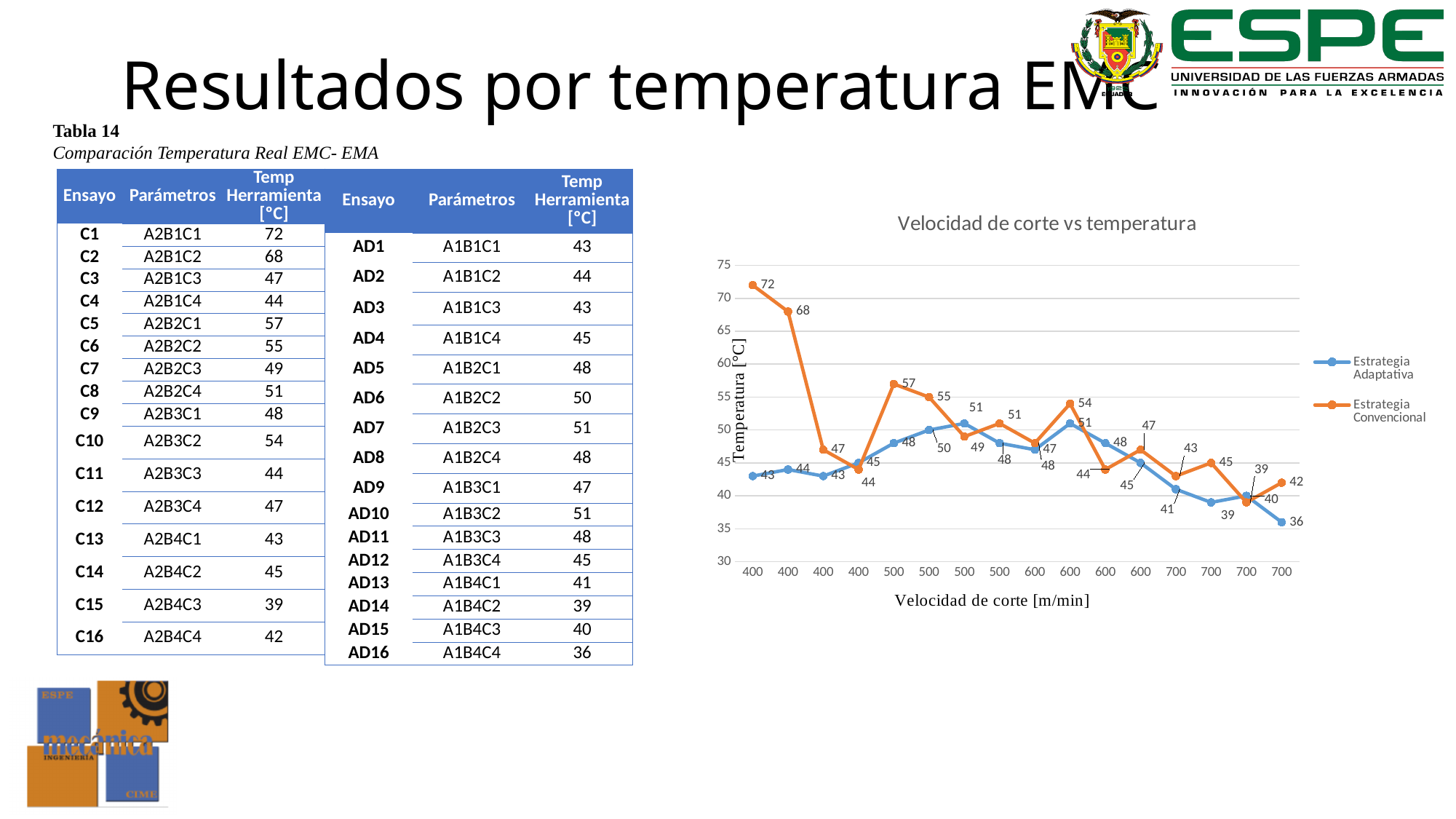
What type of chart is shown on the slide? line chart What is the label of the y axis of the chart? Temperatura [°C] What is the difference between the first point of Estrategia Convencional (72) and the first point of Estrategia Adaptativa (43)? 29 What is the highest value plotted for the Estrategia Convencional series? 72 Overall, do the values of the Estrategia Adaptativa series rise or fall from the first point to the last point? fall How many data points does each series in the chart have? 16 What is the title of the chart on the slide? Velocidad de corte vs temperatura What is the lowest value plotted for the Estrategia Adaptativa series? 36 What is the value of the last point of the Estrategia Adaptativa series? 36 At the first data point, which series has the larger value, Estrategia Adaptativa or Estrategia Convencional? Estrategia Convencional What is the value of the first point of the Estrategia Convencional series? 72 How many series does the chart legend list? 2